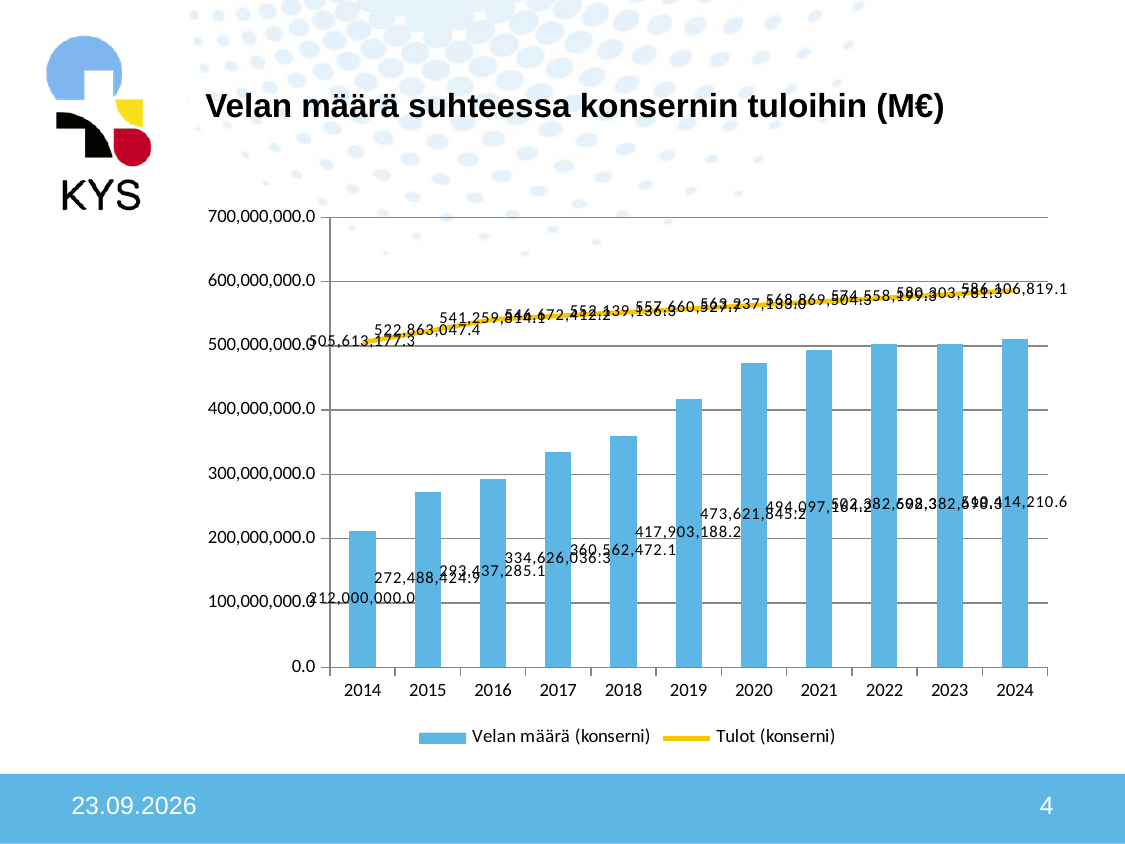
How many years are shown on the x axis of the chart? 11 What is the value of Tulot (konserni) for 2024? 586,106,819.1 Do the Velan määrä (konserni) bars rise or fall from 2014 to 2024? Rise What kind of chart is shown on the slide? Bar chart with a line How many series does the legend list? 2 Which year has the highest Velan määrä (konserni) bar? 2024 What is the value of Velan määrä (konserni) for 2014? 212,000,000.0 What is the value of Velan määrä (konserni) for 2019? 417,903,188.2 Is the Velan määrä (konserni) value for 2020 greater or less than 400,000,000.0? greater What is the value of Tulot (konserni) for 2014? 505,613,177.3 What is the difference between the Velan määrä (konserni) values for 2024 and 2014? 298,414,210.6 Which year has the lowest Velan määrä (konserni) bar? 2014